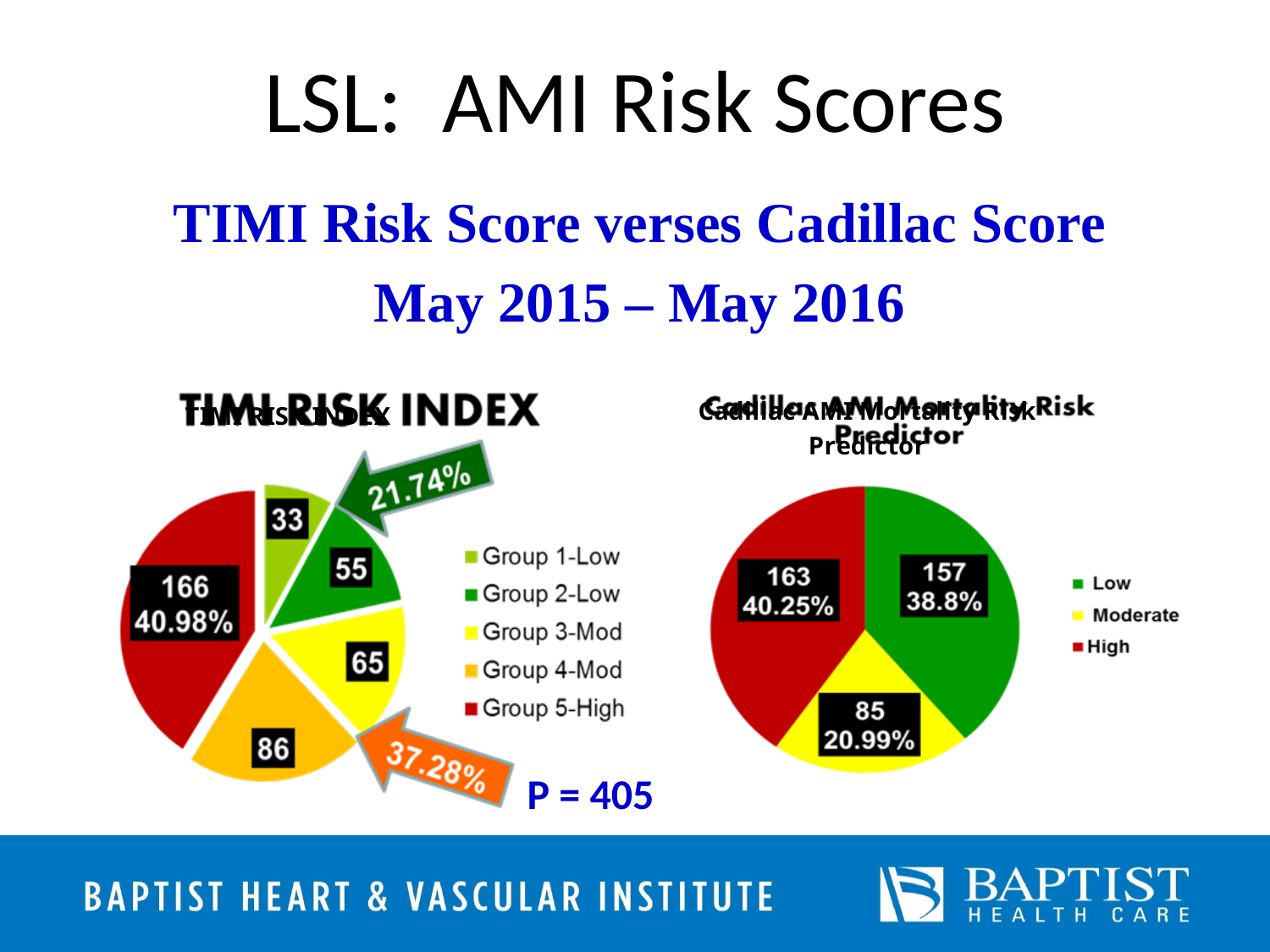
What type of chart is the Cadillac AMI Mortality Risk Predictor chart? Pie chart In the TIMI Risk Index chart, which group has the largest value? Group 5-High In the TIMI Risk Index chart, which group has the smallest value? Group 1-Low How many categories does the TIMI Risk Index legend list? 5 In the TIMI Risk Index chart, what is the value for Group 5-High? 166 In the TIMI Risk Index chart, what is the difference between Group 3-Mod and Group 2-Low? 10 In the Cadillac AMI Mortality Risk Predictor chart, what share of the pie is Low? 38.8% In the Cadillac AMI Mortality Risk Predictor chart, what is the value for Moderate? 85 In the TIMI Risk Index chart, what share of the pie does Group 5-High represent? 40.98% In the TIMI Risk Index chart, what is the value for Group 4-Mod? 86 In the Cadillac AMI Mortality Risk Predictor chart, what is the difference between High and Moderate? 78 In the Cadillac AMI Mortality Risk Predictor chart, which is larger, High or Low? High